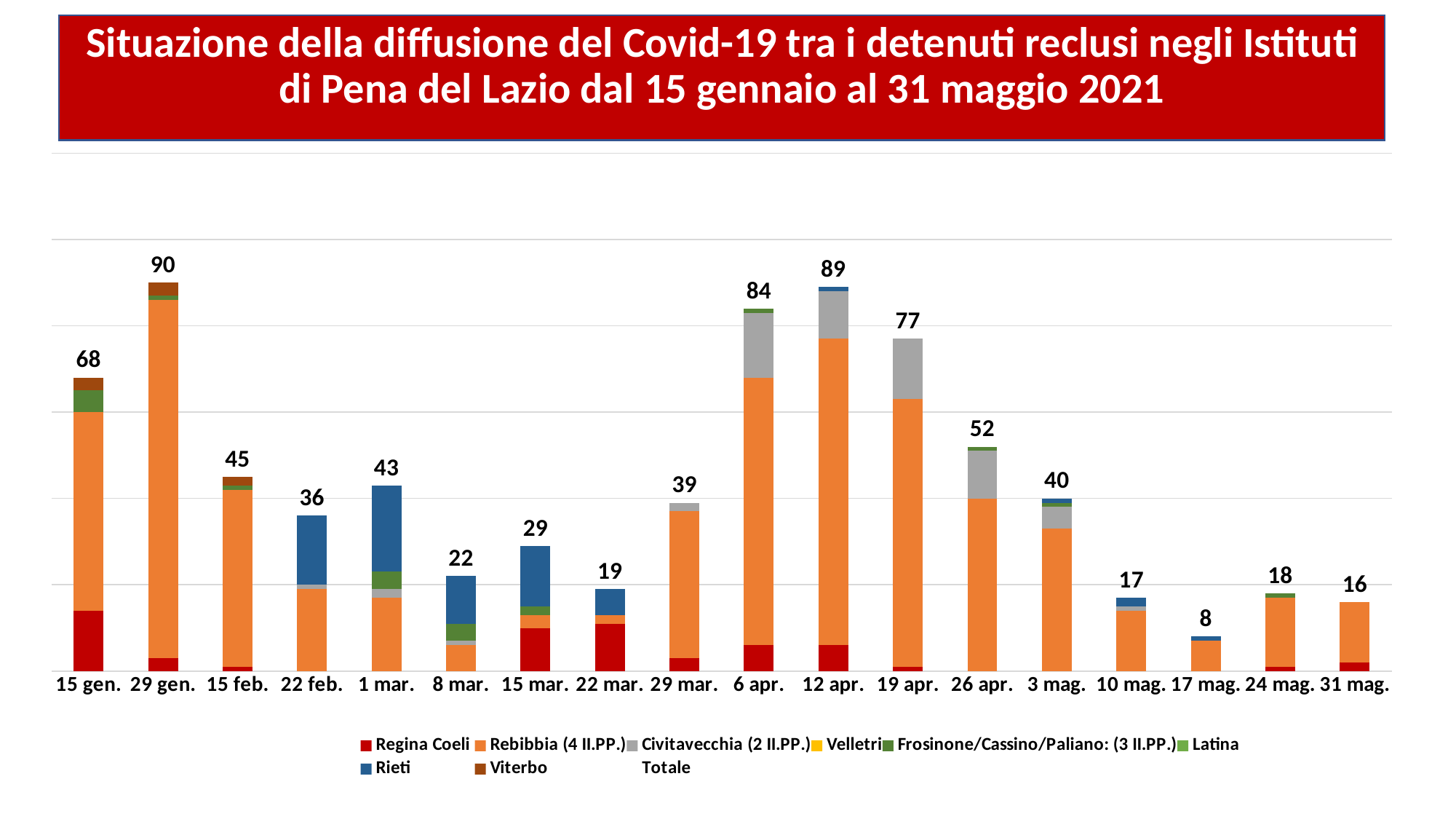
What kind of chart is shown on the slide? Stacked bar chart Which colour represents Rieti in the legend? Blue Which date has the highest total? 29 gen. Which date has the lowest total? 17 mag. How many entries does the legend list? 9 What is the total value shown for 17 mag.? 8 How many dates are shown on the x axis? 18 What is the total number of cases shown for 29 gen.? 90 What is the difference between the totals for 6 apr. and 26 apr.? 32 What is the total value labelled above the bar for 12 apr.? 89 Do the totals rise or fall from 12 apr. to 17 mag.? Fall Which has a larger total, 15 feb. or 1 mar.? 15 feb.